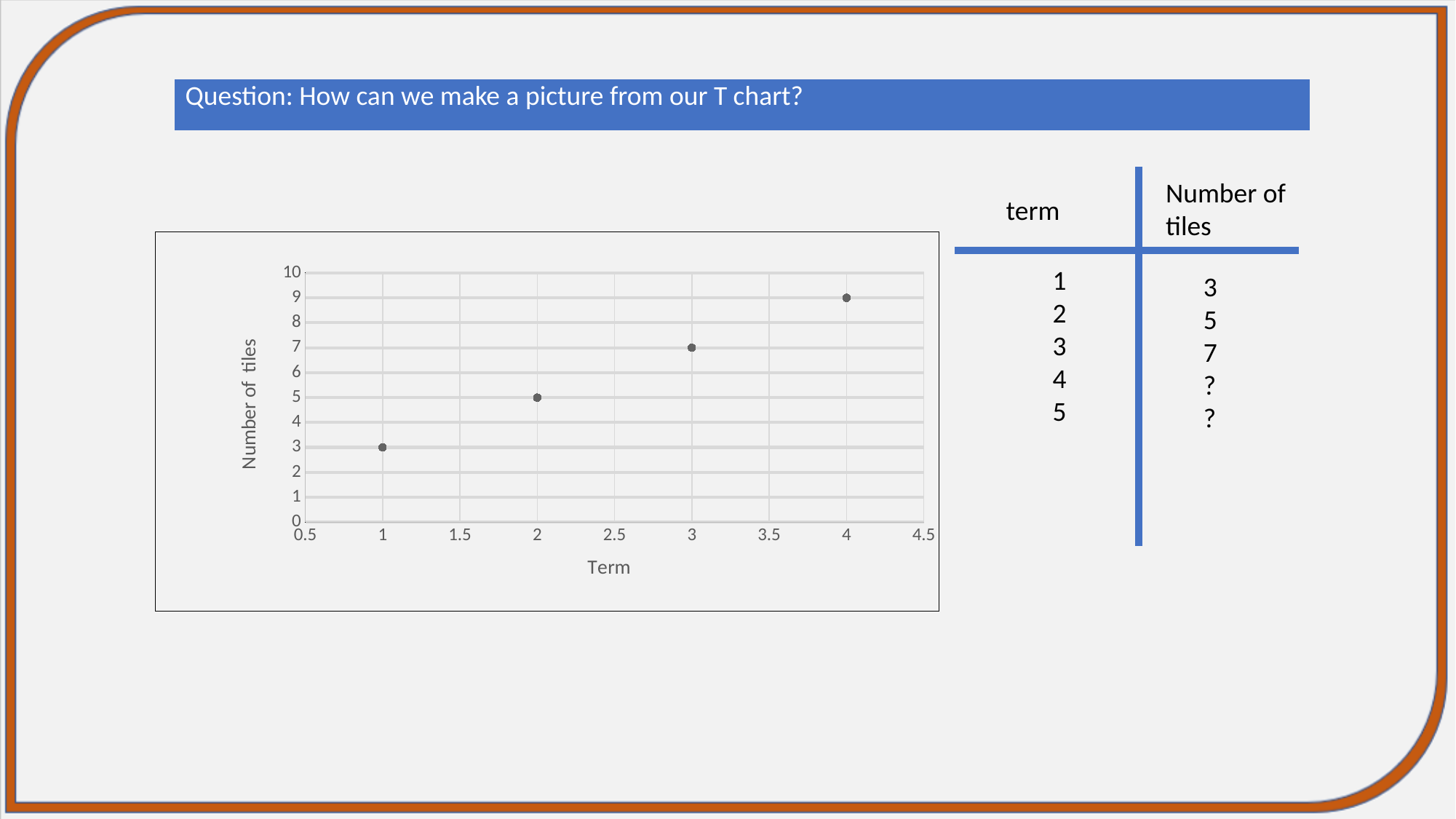
What is the label of the vertical axis? Number of tiles Which term has the lowest number of tiles? 1 Do the values rise or fall as the term increases? rise What is the number of tiles at term 1? 3 What is the number of tiles at term 2? 5 What is the difference in number of tiles between term 4 and term 1? 6 What kind of chart is shown on the slide? scatter chart Which term has the highest number of tiles? 4 How many data points are plotted on the chart? 4 What is the number of tiles at term 3? 7 What is the number of tiles at term 4? 9 Which has more tiles, term 2 or term 3? term 3